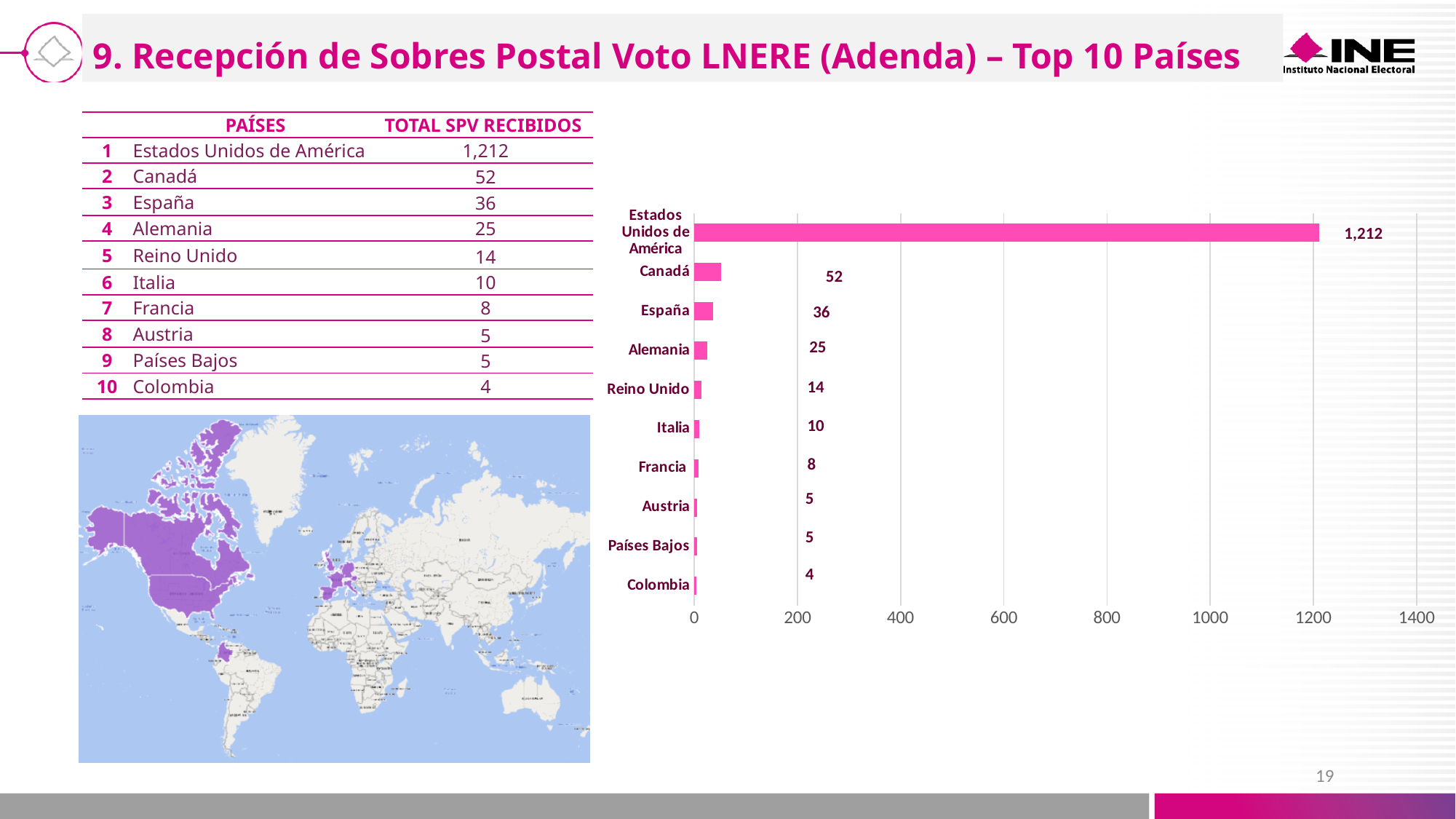
What kind of chart is shown on the slide? bar chart How many countries are shown in the bar chart? 10 Which country has the lowest value in the bar chart? Colombia What is the value for Alemania in the bar chart? 25 What is the maximum value shown on the horizontal axis of the bar chart? 1400 Which country has the highest value in the bar chart? Estados Unidos de América What is the value for Estados Unidos de América in the bar chart? 1,212 What is the difference between the values for Canadá and España in the bar chart? 16 Is the value for Estados Unidos de América greater or less than 1000? greater What is the value for Reino Unido in the bar chart? 14 What is the value for Canadá in the bar chart? 52 Which has a larger value in the bar chart, Italia or Francia? Italia